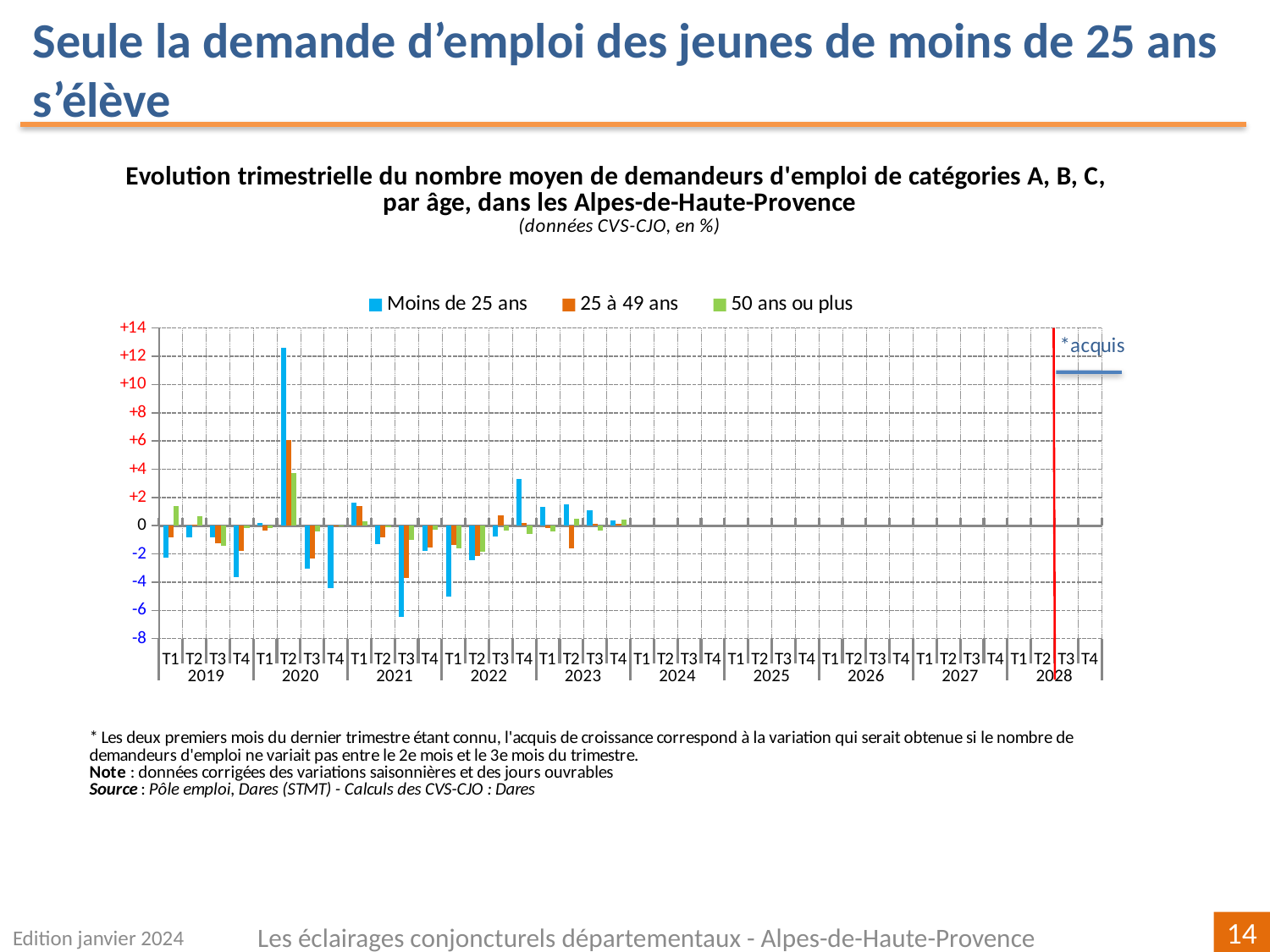
In T2 2020, which series has the larger value: 'Moins de 25 ans' or '25 à 49 ans'? Moins de 25 ans What is the highest tick value shown on the vertical axis? +14 In T3 2021, which series has the lower value: 'Moins de 25 ans' or '50 ans ou plus'? Moins de 25 ans Is the value for 'Moins de 25 ans' in T2 2020 greater or less than +10? greater What kind of chart is shown on the slide? bar chart In which quarter does the 'Moins de 25 ans' series reach its highest value? T2 2020 How many series does the legend list? 3 Is the value for '25 à 49 ans' in T2 2020 greater or less than +4? greater Is the value for 'Moins de 25 ans' in T1 2022 greater or less than -4? less In which quarter does the 'Moins de 25 ans' series reach its lowest value? T3 2021 What are the three series named in the legend? Moins de 25 ans, 25 à 49 ans, 50 ans ou plus